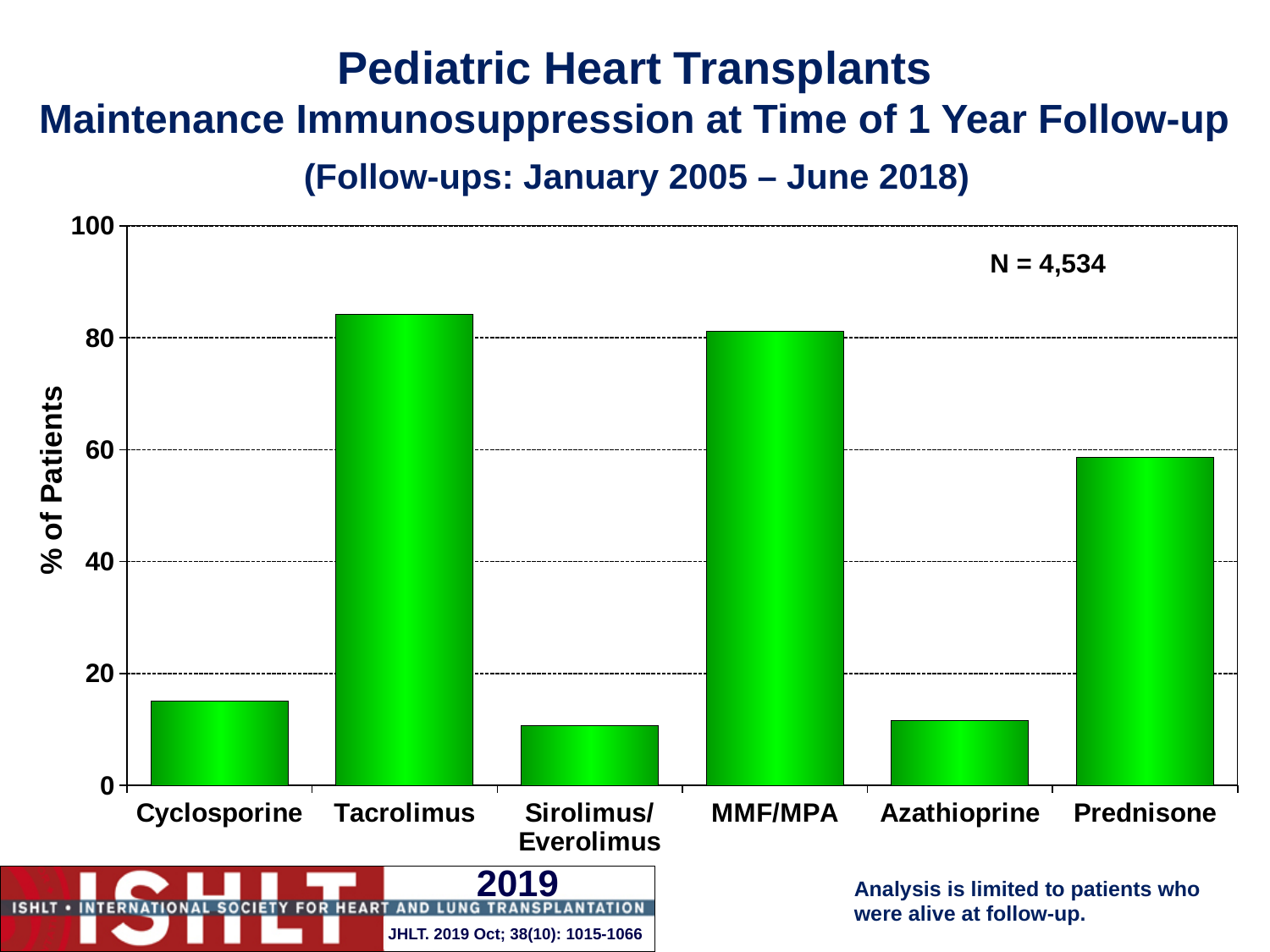
What is the N value shown on the chart? N = 4,534 Is the value for Cyclosporine greater or less than 20? less Which has a higher % of patients, Tacrolimus or Cyclosporine? Tacrolimus Is the value for MMF/MPA greater or less than 80? greater Is the value for Tacrolimus greater or less than 80? greater How many immunosuppression categories are shown on the x axis? 6 What is the label of the y axis? % of Patients Which has a higher % of patients, Prednisone or Azathioprine? Prednisone What kind of chart is shown on the slide? bar chart